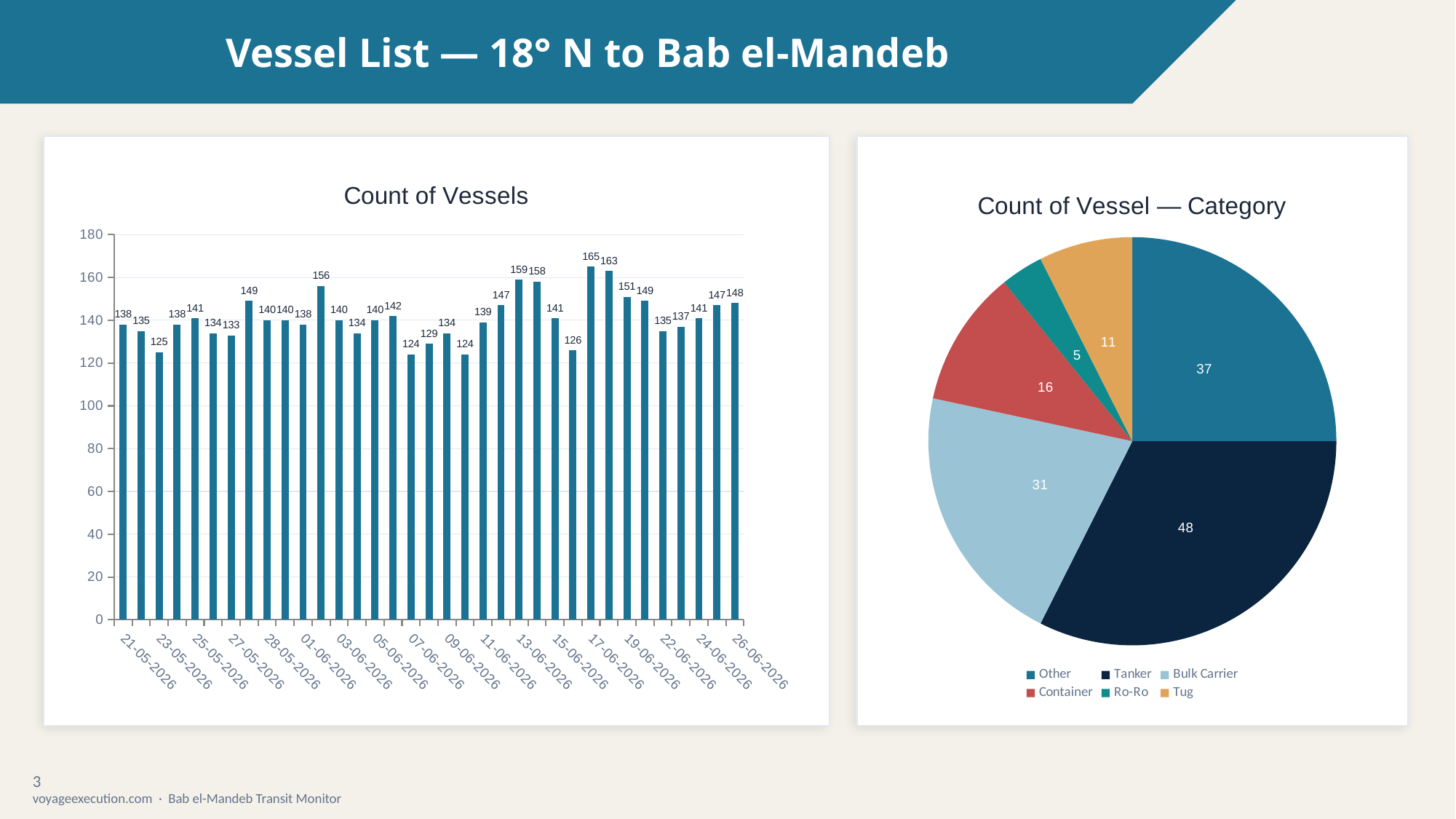
In the 'Count of Vessel — Category' pie chart, what is the difference between the Other and Container values? 21 In the 'Count of Vessel — Category' pie chart, which category has the smallest slice? Ro-Ro In the 'Count of Vessel — Category' pie chart, what is the value for Tanker? 48 In the 'Count of Vessels' chart on the left, what is the highest value shown? 165 What kind of chart is the 'Count of Vessels' chart on the left? Bar chart In the 'Count of Vessel — Category' pie chart, what share of the total does the Other slice represent? 25% In the 'Count of Vessel — Category' pie chart, what is the total of all slices? 148 In the 'Count of Vessels' chart on the left, what is the lowest value shown? 124 In the 'Count of Vessel — Category' pie chart, which category has the largest slice? Tanker In the 'Count of Vessel — Category' pie chart, what is the value for Bulk Carrier? 31 In the 'Count of Vessel — Category' pie chart, which is larger: Bulk Carrier or Other? Other How many categories does the legend of the 'Count of Vessel — Category' pie chart list? 6